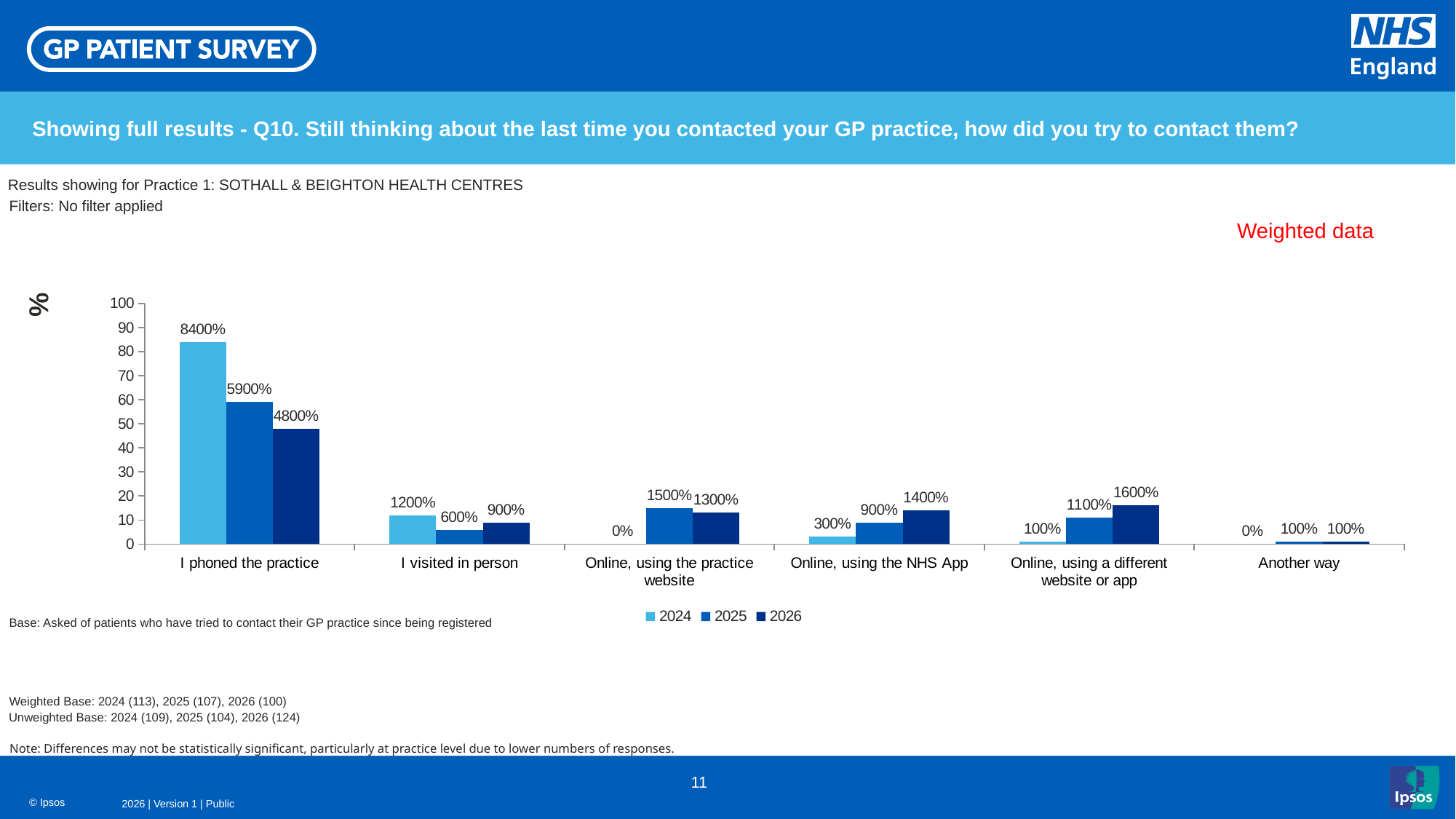
Which is larger for 'Online, using a different website or app': the 2025 value or the 2026 value? 2026 How many series does the legend list? 3 Does the value for 'I phoned the practice' rise or fall from 2024 to 2026? Fall Which category has the highest value in the 2026 series? I phoned the practice What is the data label for 'I visited in person' in the 2025 series? 600% Which category has the lowest value in the 2025 series? Another way How many categories are shown on the x axis? 6 What is the data label for 'Online, using the NHS App' in the 2026 series? 1400% What is the data label for 'Online, using the practice website' in the 2024 series? 0% What type of chart is shown on the slide? Bar chart What is the difference between the 2024 and 2025 data labels for 'I phoned the practice'? 2500% What is the data label for 'I phoned the practice' in the 2024 series? 8400%